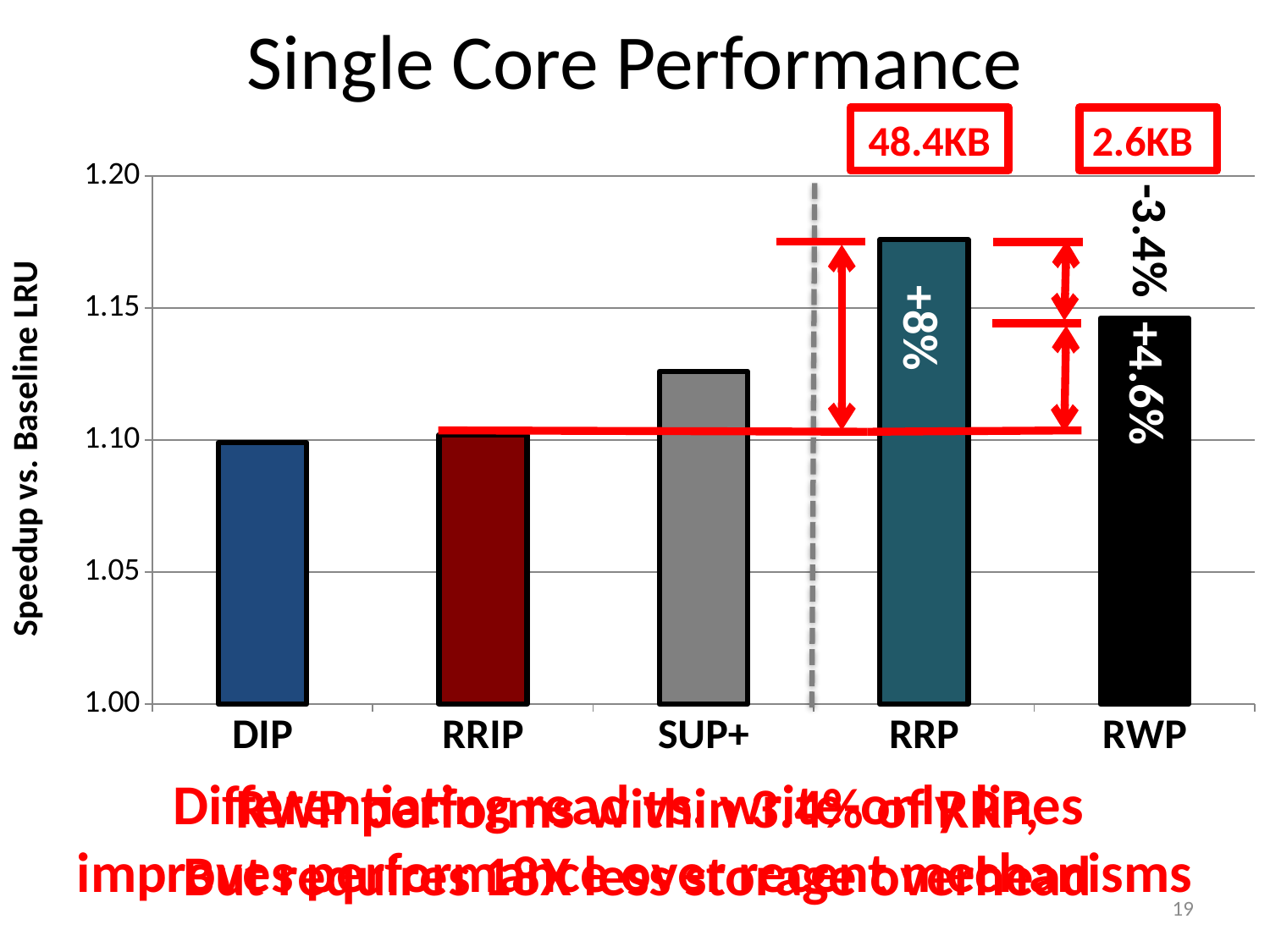
How many categories are plotted on the x axis? 5 Which category has the highest speedup? RRP Is the value for DIP greater or less than 1.15? less What is the label of the y axis? Speedup vs. Baseline LRU Which is larger, the value for RRP or the value for RWP? RRP Is the value for RWP greater or less than 1.10? greater What storage size is annotated above the RWP bar? 2.6KB Which is larger, the value for SUP+ or the value for RWP? RWP Is the value for RRP greater or less than 1.15? greater What kind of chart is shown on the slide? bar chart Which is larger, the value for DIP or the value for SUP+? SUP+